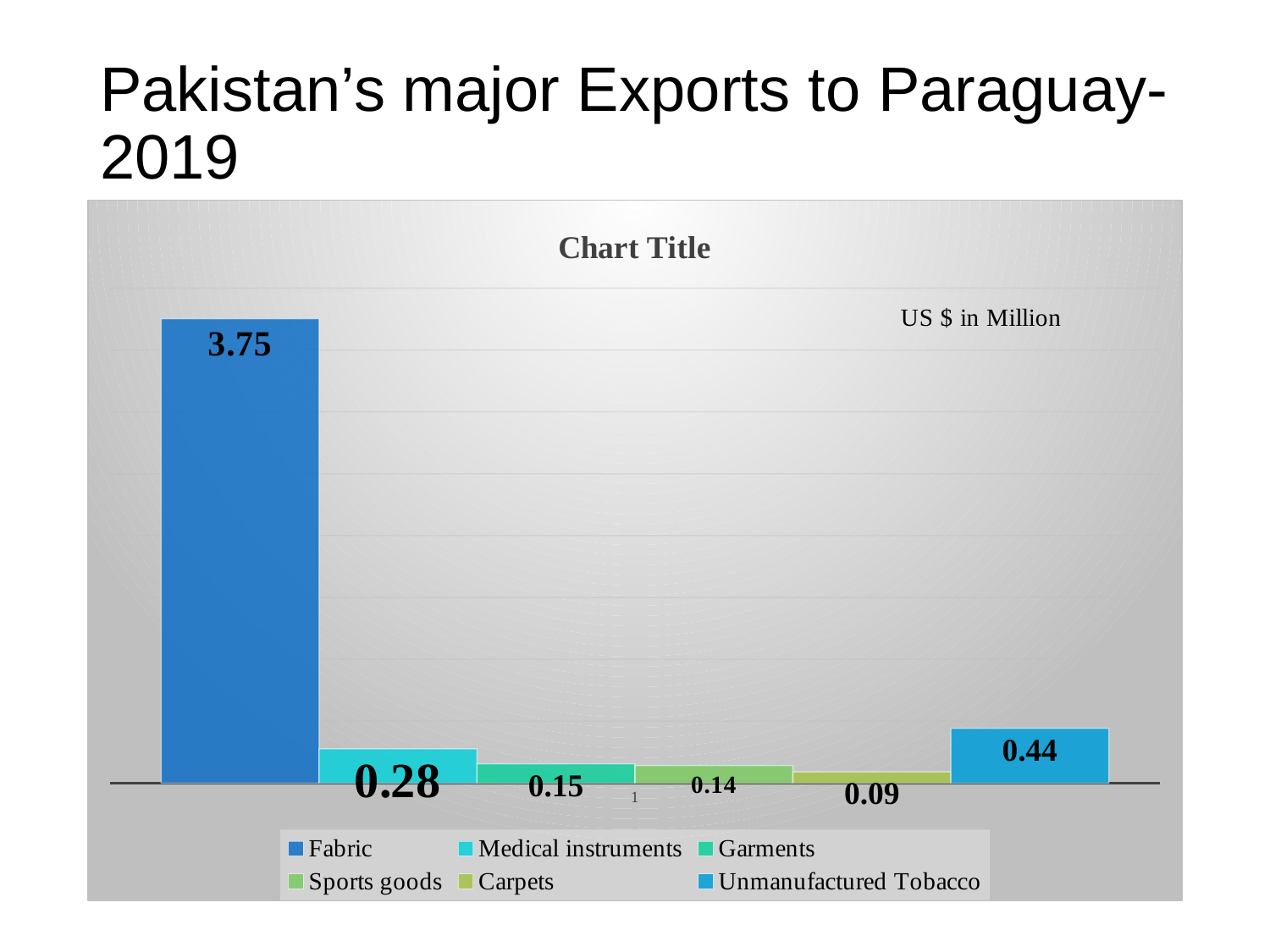
What is the difference between the values for Garments and Sports goods? 0.01 Which export category has the lowest value? Carpets What kind of chart is shown on the slide? Bar chart How many series does the legend list? 6 What is the value for Carpets? 0.09 Which is larger, the value for Medical instruments or the value for Unmanufactured Tobacco? Unmanufactured Tobacco What is the value for Medical instruments? 0.28 What is the value for Unmanufactured Tobacco? 0.44 Which export category has the highest value? Fabric What unit is stated for the values in the chart? US $ in Million What is the value for Fabric? 3.75 What is the difference between the values for Fabric and Unmanufactured Tobacco? 3.31